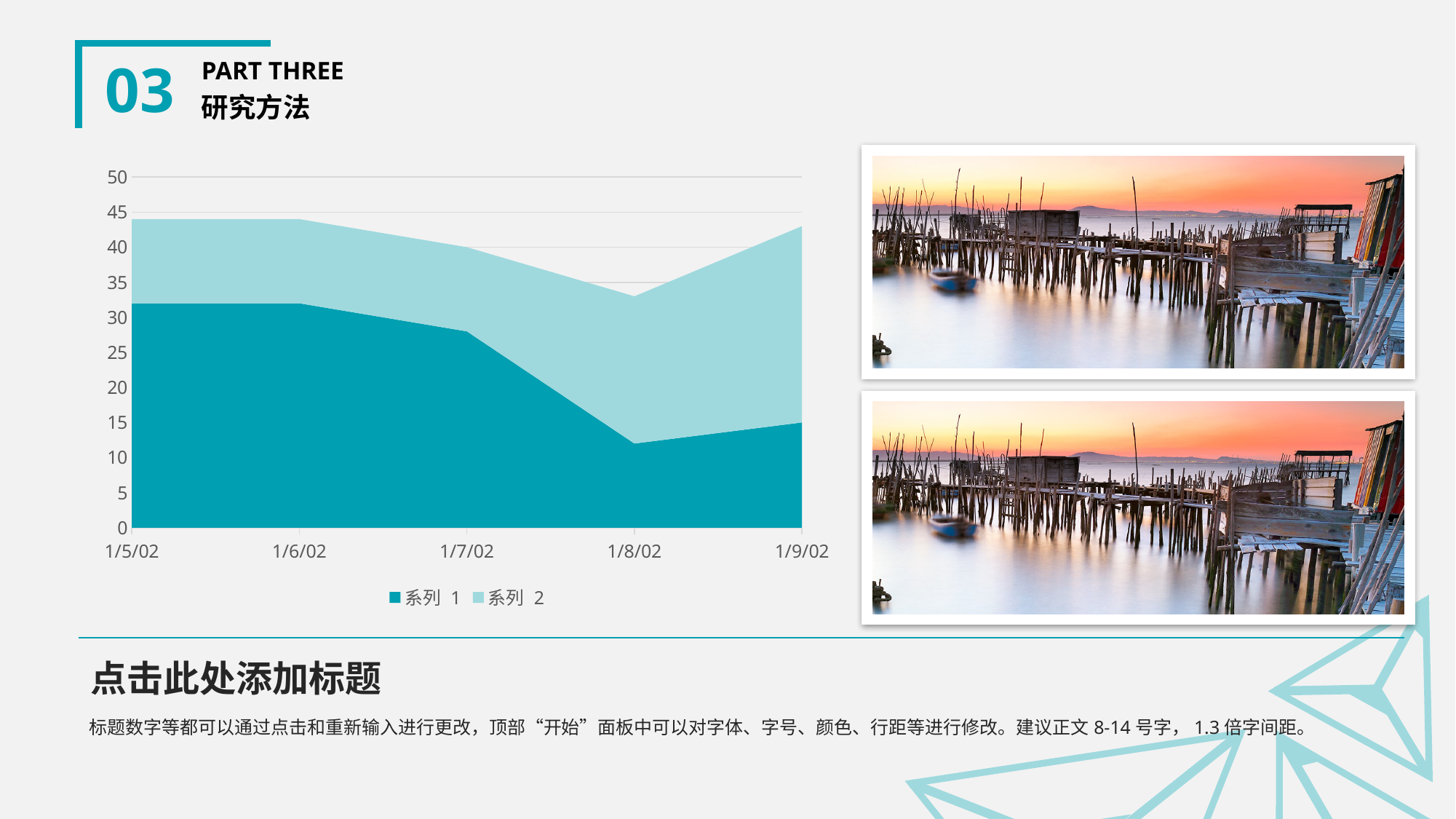
Is the value for 系列 1 at 1/5/02 greater or less than 25? greater Is the stacked total of the two series at 1/8/02 greater or less than 40? less Does the value of 系列 1 rise or fall from 1/6/02 to 1/8/02? fall Which is larger for 系列 1: the value at 1/6/02 or the value at 1/8/02? 1/6/02 What kind of chart is shown on the slide? Stacked area chart How many series does the chart legend list? 2 On which date does 系列 1 reach its lowest value? 1/8/02 What are the two legend entries of the chart? 系列 1 and 系列 2 How many dates are shown along the x axis of the chart? 5 On which date is the stacked total of the two series lowest? 1/8/02 Is the stacked total of the two series at 1/5/02 greater or less than 40? greater